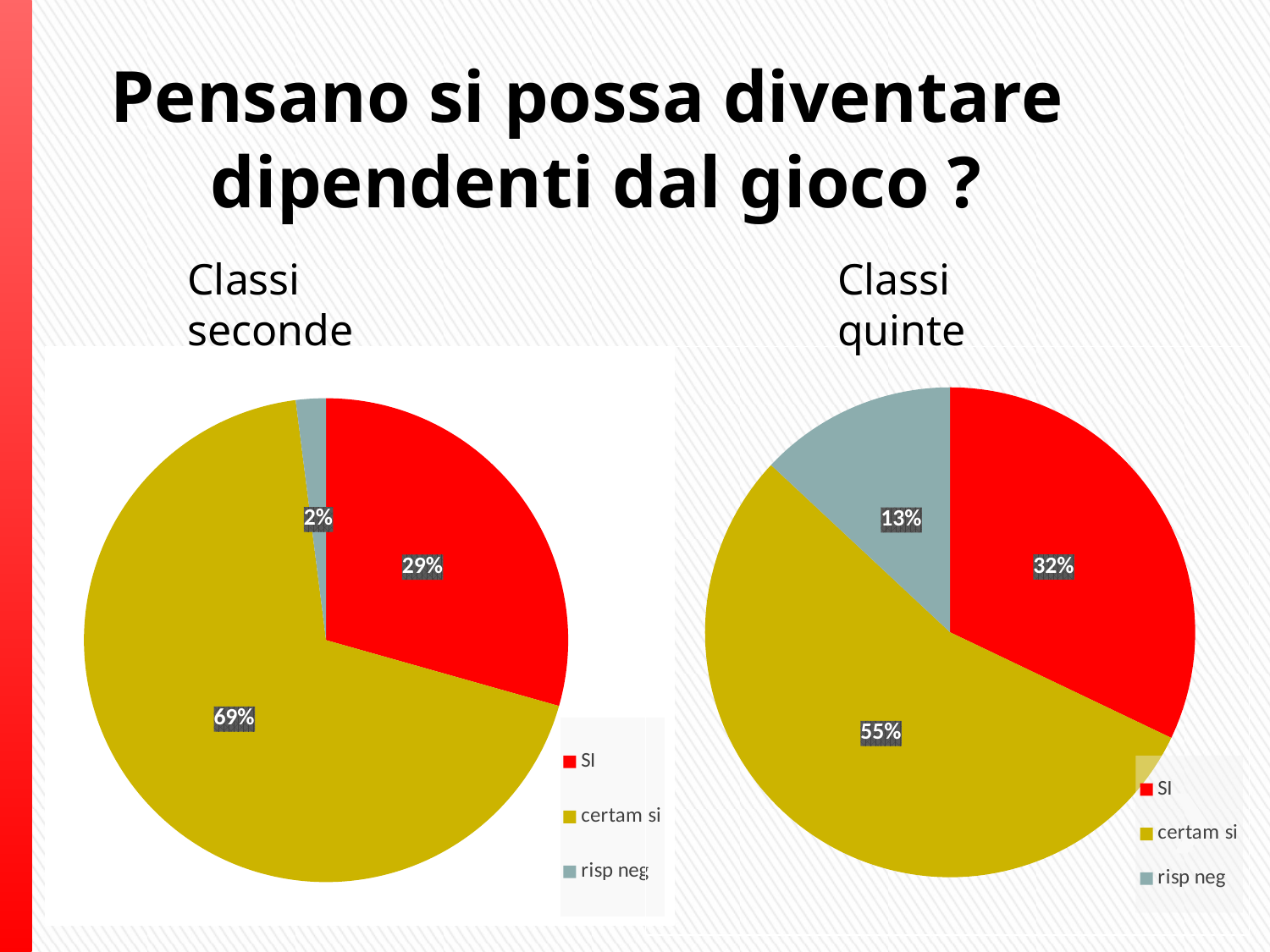
In the 'Classi seconde' pie chart, what is the share for 'certam si'? 69% In the 'Classi quinte' pie chart, what is the difference between the 'SI' and 'risp neg' shares? 19% In the 'Classi quinte' pie chart, what is the share for 'risp neg'? 13% What kind of chart is used for 'Classi quinte'? Pie chart In the 'Classi quinte' pie chart, which category has the largest slice? certam si Which chart has the larger share for 'SI', 'Classi seconde' or 'Classi quinte'? Classi quinte In the 'Classi seconde' pie chart, what is the share for 'SI'? 29% In the 'Classi seconde' pie chart, which category has the smallest slice? risp neg In the 'Classi quinte' pie chart, what is the share for 'certam si'? 55% In the 'Classi quinte' pie chart, what colour is the 'SI' slice? Red How many slices does the 'Classi seconde' pie chart have? 3 In the 'Classi seconde' pie chart, what is the share for 'risp neg'? 2%